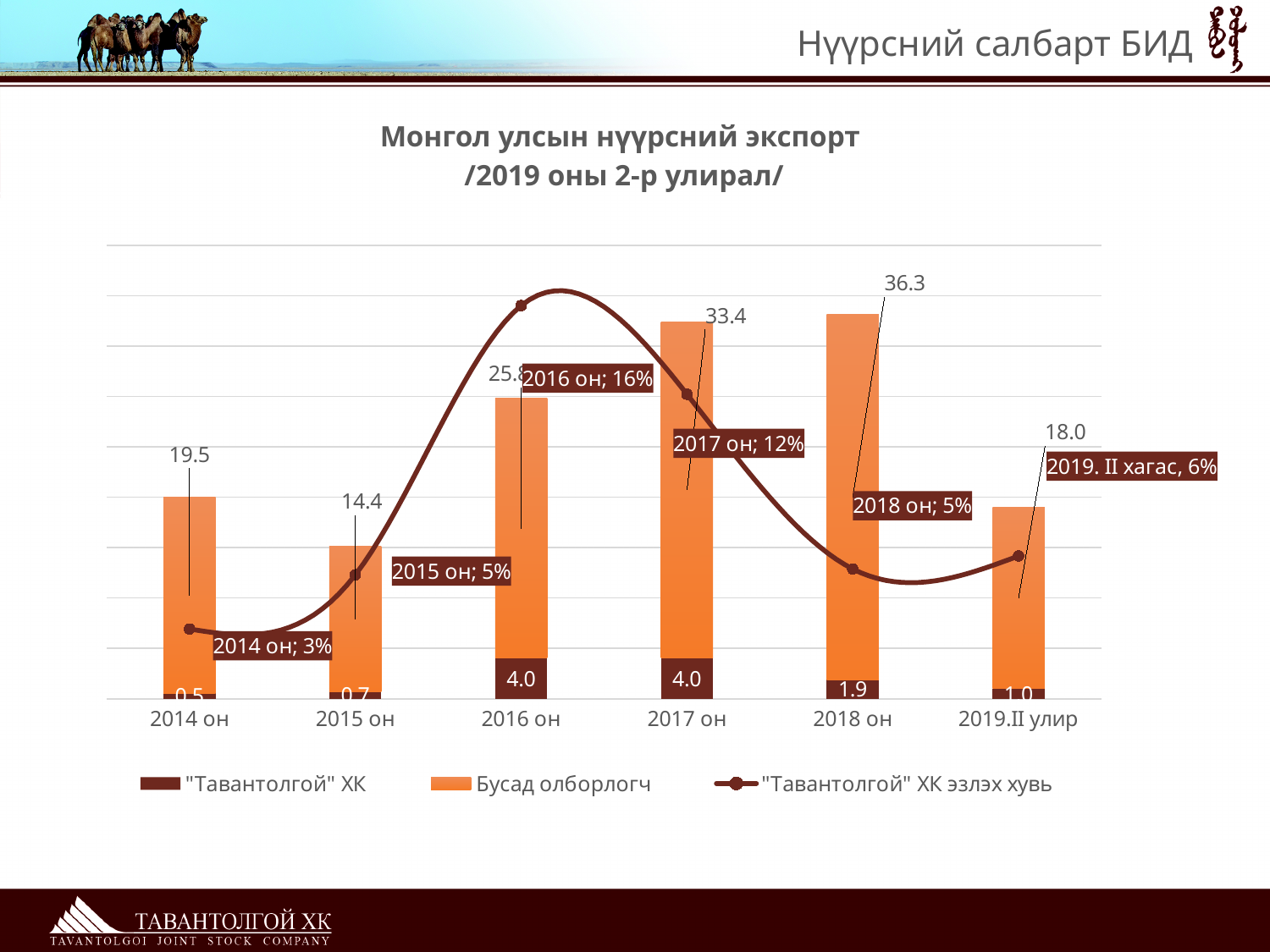
What is the "Тавантолгой" ХК эзлэх хувь value shown for 2019. II хагас? 6% What is the difference between the "Бусад олборлогч" values for 2018 он and 2017 он? 2.9 Which is larger, the "Тавантолгой" ХК value for 2018 он or for 2019.II улир? 2018 он In which category is the "Бусад олборлогч" value highest? 2018 он How many series does the legend list? 3 What kind of chart is shown on the slide? bar chart How many categories are shown on the x axis? 6 Does the "Тавантолгой" ХК эзлэх хувь line rise or fall from 2016 он to 2018 он? fall What is the "Тавантолгой" ХК эзлэх хувь value shown for 2016 он? 16% What is the value for "Бусад олборлогч" in 2018 он? 36.3 In which category is the "Тавантолгой" ХК value lowest? 2014 он What is the value for "Тавантолгой" ХК in 2016 он? 4.0